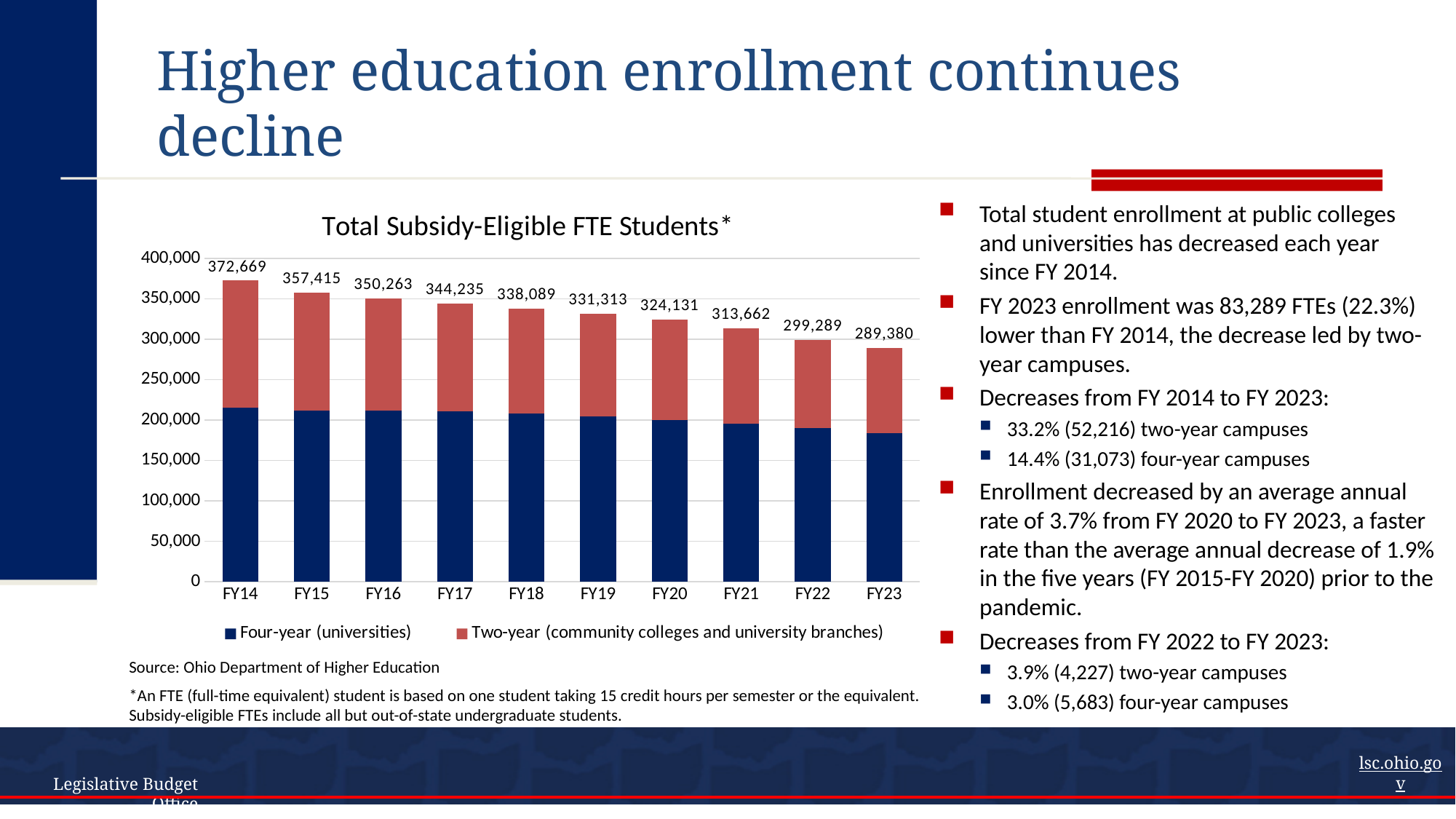
What is the total number of subsidy-eligible FTE students shown for FY23? 289,380 Which is larger, the total for FY21 or the total for FY22? FY21 Which fiscal year has the lowest total FTE students? FY23 How many fiscal years are shown on the x axis? 10 How many series does the legend list? 2 Is the Four-year (universities) value for FY23 greater or less than 200,000? less What kind of chart is shown? Stacked bar chart Do the total FTE student values rise or fall from FY14 to FY23? Fall What is the total value labeled for FY19? 331,313 What is the difference between the FY14 total and the FY23 total? 83,289 What is the total number of subsidy-eligible FTE students shown for FY14? 372,669 Which fiscal year has the highest total FTE students? FY14